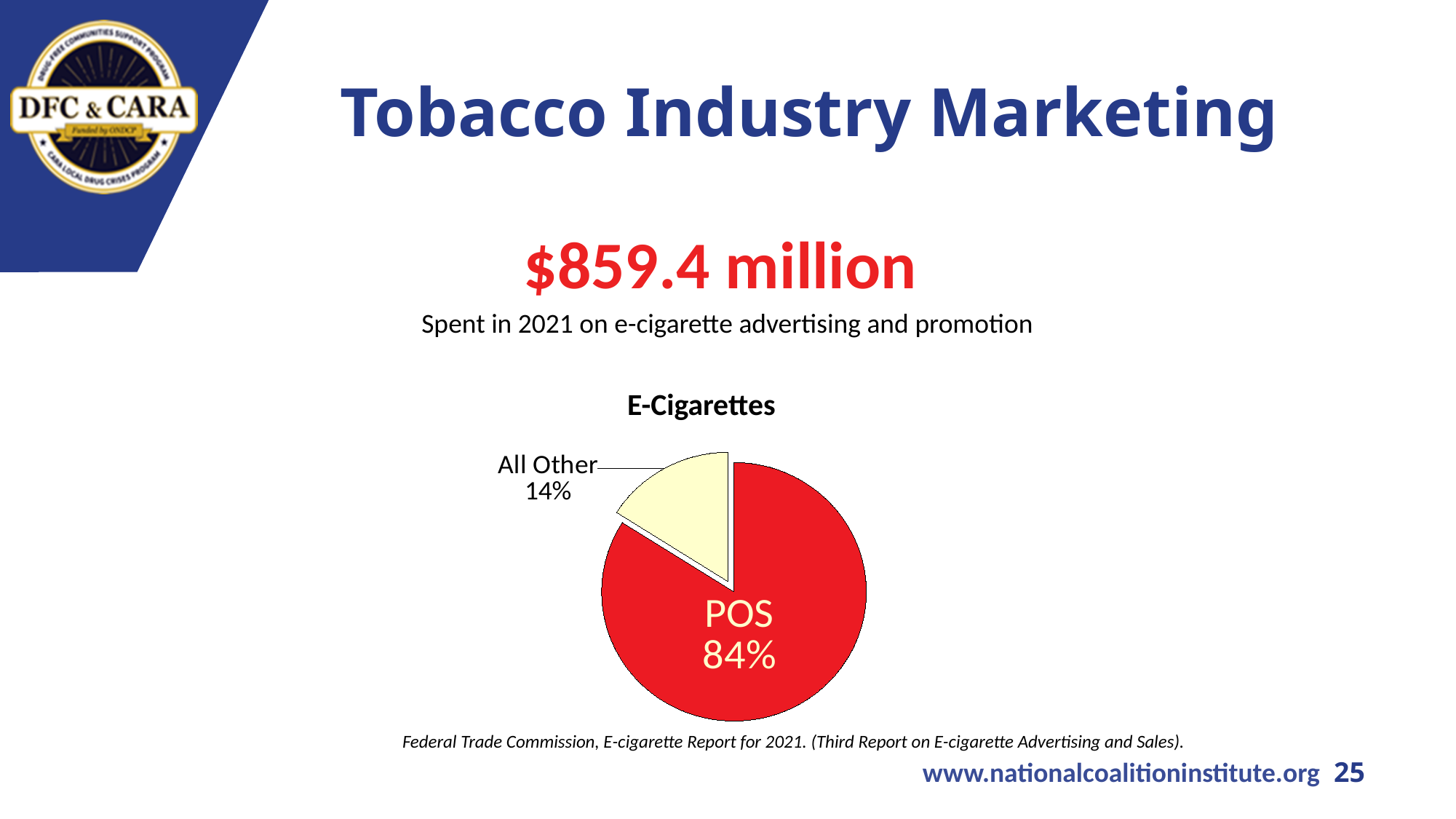
What kind of chart is shown on the slide? Pie chart What share of the E-Cigarettes pie chart is POS? 84% How many slices does the E-Cigarettes pie chart have? 2 What is the difference in percentage points between the POS and All Other slices in the E-Cigarettes pie chart? 70 percentage points Which slice of the E-Cigarettes pie chart is the largest? POS What colour is the POS slice in the E-Cigarettes pie chart? Red In the E-Cigarettes pie chart, which is larger: POS or All Other? POS Which slice of the E-Cigarettes pie chart is the smallest? All Other What share of the E-Cigarettes pie chart is All Other? 14% What is the title of the chart on the slide? E-Cigarettes